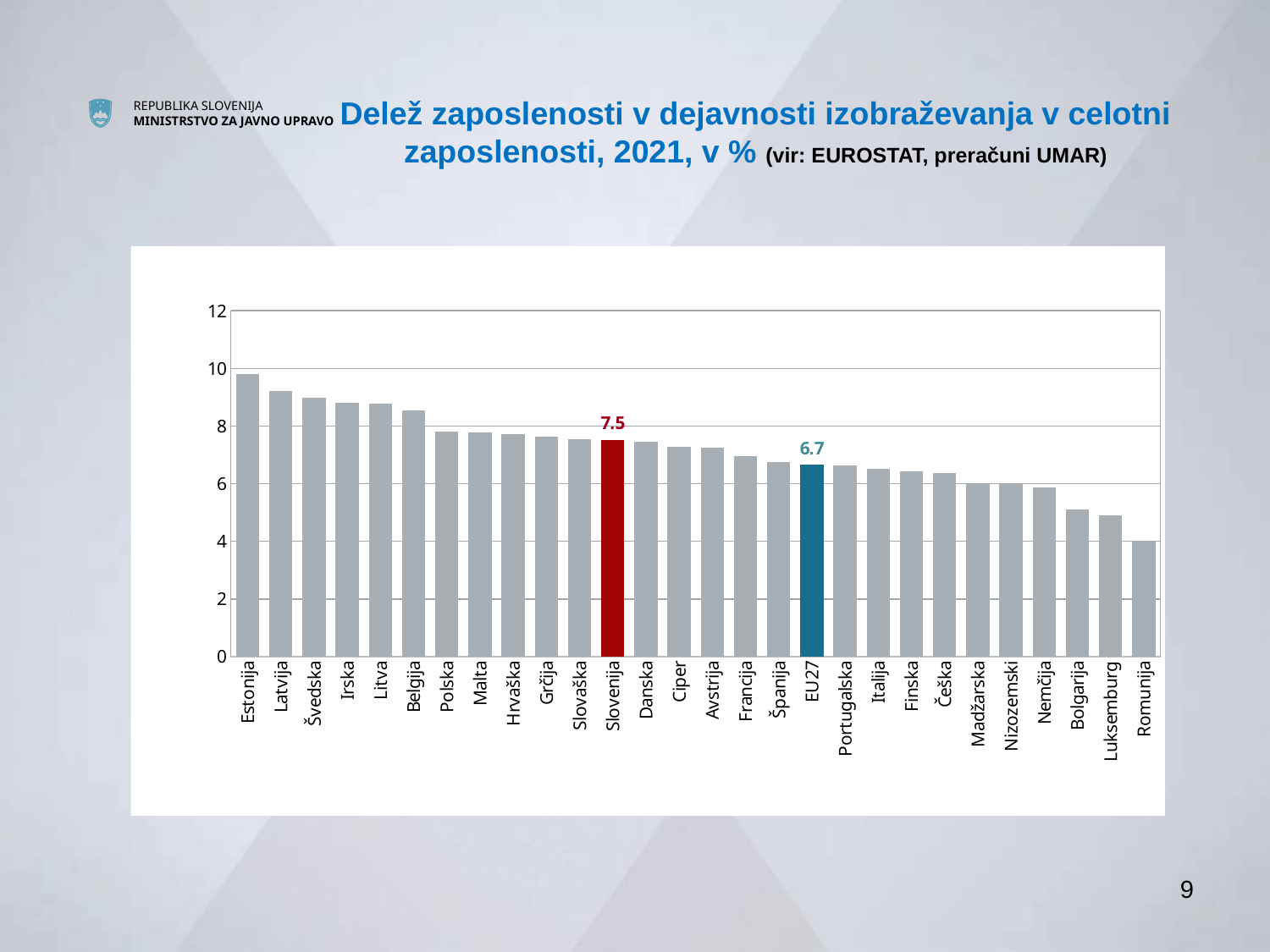
Which country has the highest value? Estonija How many bars are plotted in the chart? 28 What type of chart is shown on the slide? bar chart What is the value for Slovenija? 7.5 What is the difference between the values for Slovenija and EU27? 0.8 Is the value for Romunija greater or less than 6? less What is the value for EU27? 6.7 Is the value for Luksemburg greater or less than 6? less Do the values rise or fall from left to right along the x axis? fall Is the value for Estonija greater or less than 8? greater Which is larger, the value for Slovenija or the value for EU27? Slovenija Which country has the lowest value? Romunija